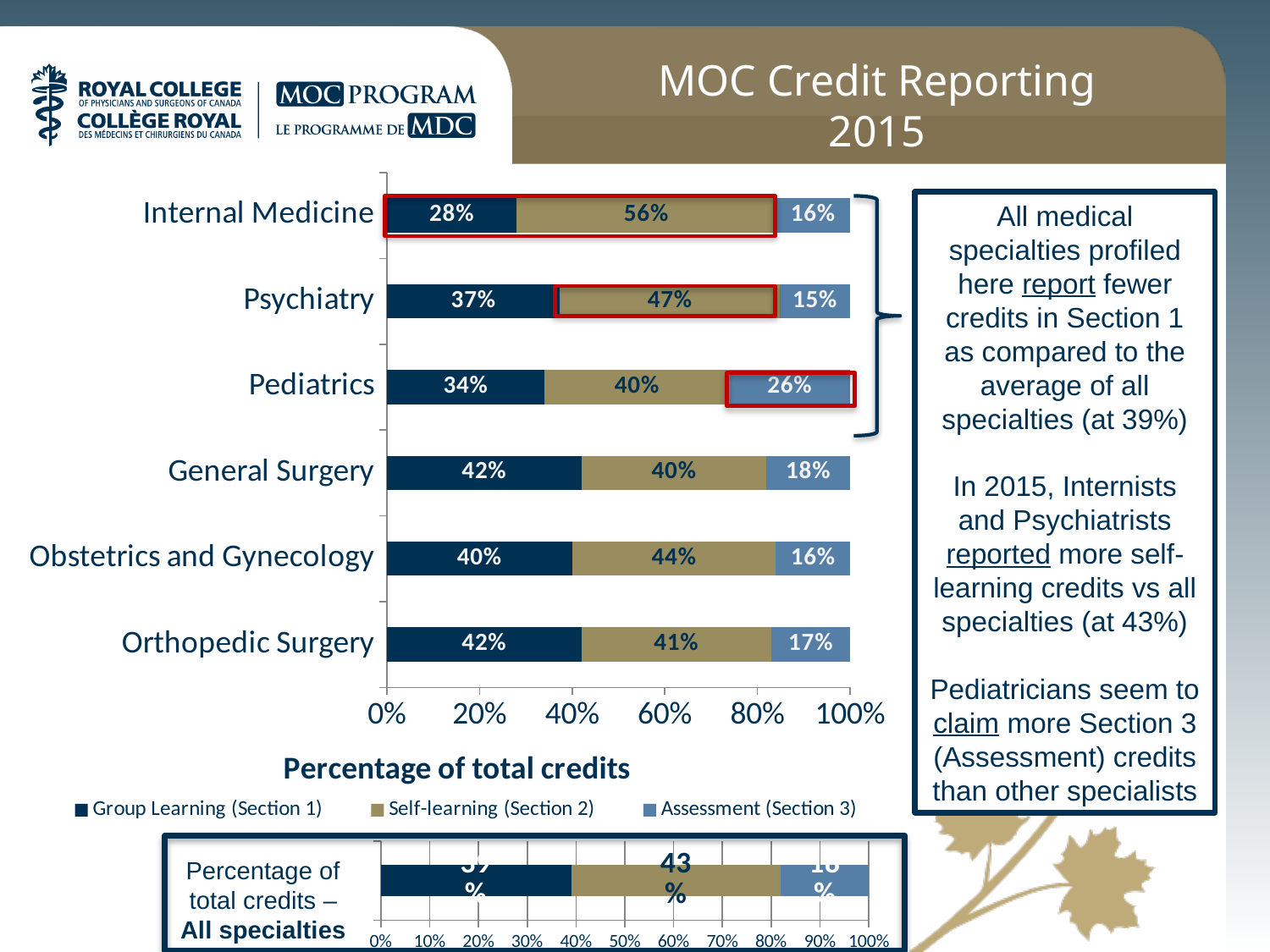
In the main chart, what is the Self-learning (Section 2) value for Psychiatry? 47% How many series does the legend of the main chart list? 3 In the main chart, which specialty has the lowest Group Learning (Section 1) percentage? Internal Medicine In the main chart, what is the difference between the Group Learning (Section 1) values for General Surgery and Internal Medicine? 14% In the main chart, which is larger: the Self-learning (Section 2) value for Obstetrics and Gynecology or for Orthopedic Surgery? Obstetrics and Gynecology What is the axis title shown below the main chart? Percentage of total credits In the main chart, which specialty has the highest Self-learning (Section 2) percentage? Internal Medicine In the main chart, what is the Assessment (Section 3) value for Pediatrics? 26% In the main chart, what is the Group Learning (Section 1) value for Internal Medicine? 28% What type of chart is the main chart on the slide? Stacked bar chart In the main chart, which specialty has the highest Assessment (Section 3) percentage? Pediatrics How many specialties are shown in the main chart? 6